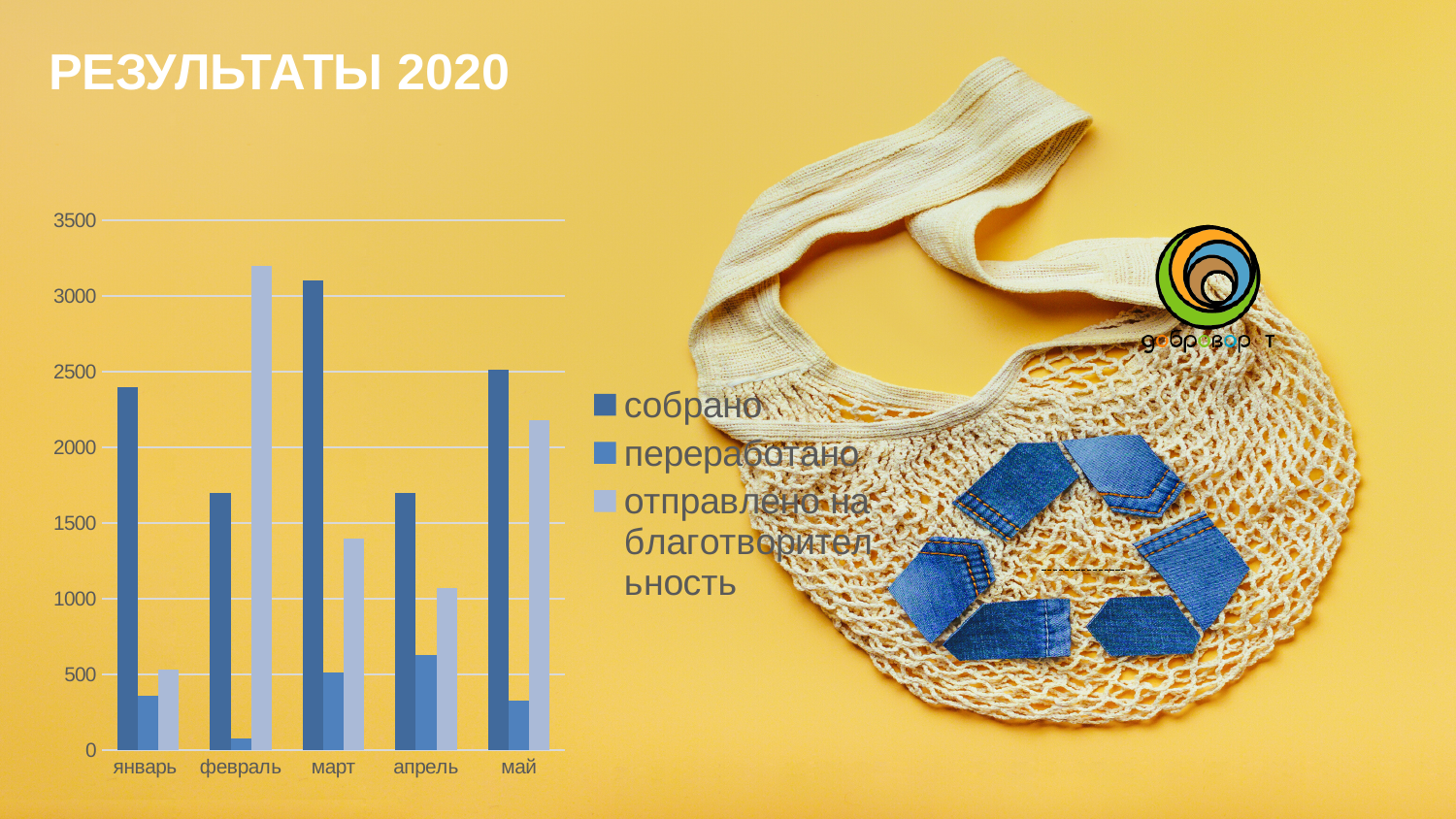
In which month is the value for отправлено на благотворительность the highest? февраль In февраль, which is larger: собрано or отправлено на благотворительность? отправлено на благотворительность Is the value for переработано in февраль greater or less than 500? less How many months are shown on the x axis of the chart? 5 Is the value for собрано in март greater or less than 3000? greater In which month is the value for собрано the highest? март In январь, which is larger: собрано or отправлено на благотворительность? собрано How many series does the chart legend list? 3 What kind of chart is shown on the slide? bar chart What is the title of the slide containing the chart? РЕЗУЛЬТАТЫ 2020 In which month is the value for переработано the lowest? февраль Is the value for отправлено на благотворительность in май greater or less than 2000? greater